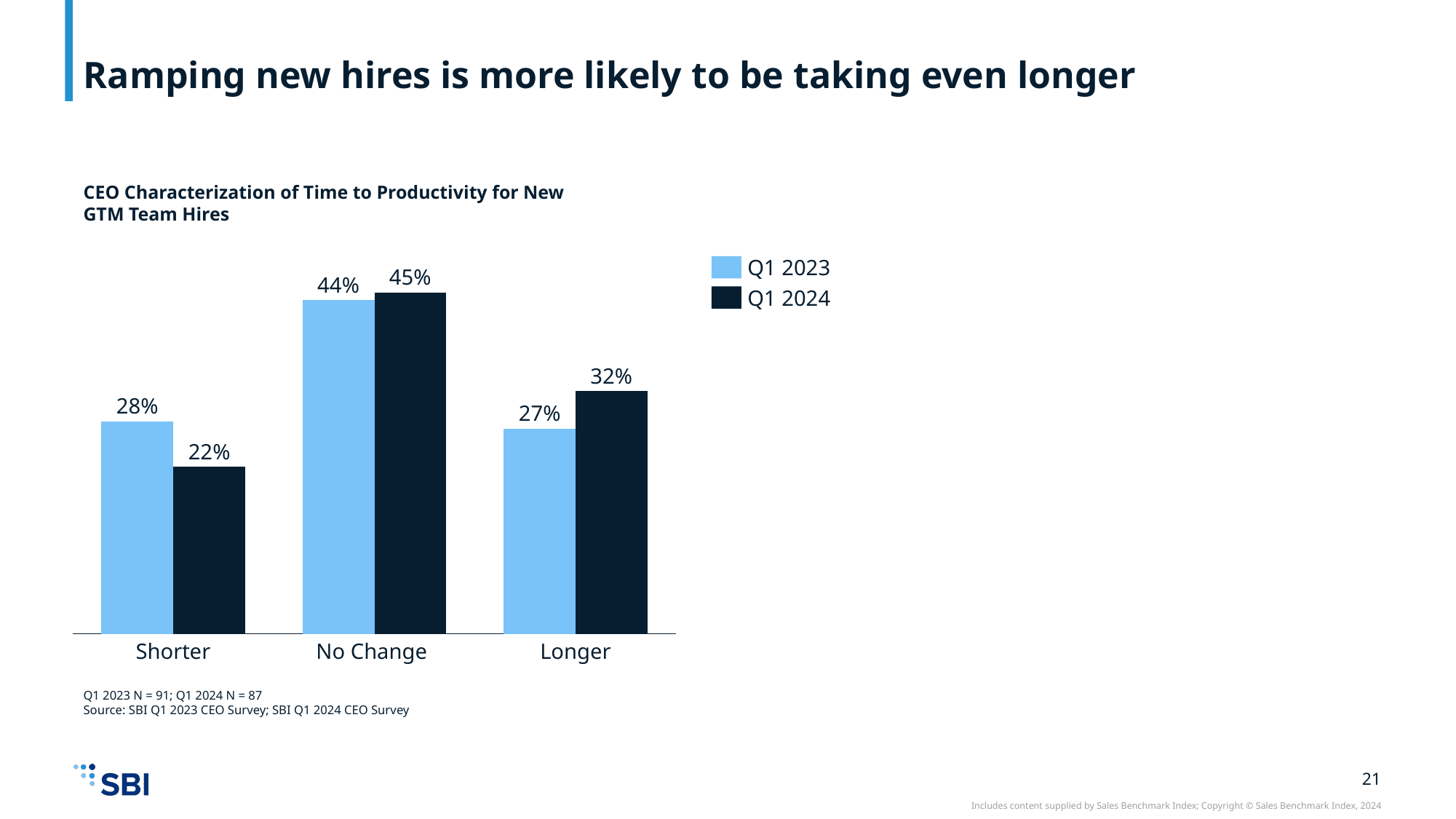
What is the difference between the Q1 2024 and Q1 2023 values for the Longer category? 5% What is the Q1 2024 value for the No Change category? 45% For the Shorter category, which is larger: the Q1 2023 value or the Q1 2024 value? Q1 2023 What is the difference between the Q1 2023 and Q1 2024 values for the Shorter category? 6% What is the title of the chart? CEO Characterization of Time to Productivity for New GTM Team Hires What is the Q1 2023 value for the Shorter category? 28% How many series does the legend list? 2 What is the Q1 2024 value for the Longer category? 32% Which category has the highest Q1 2023 value? No Change What kind of chart is shown on the slide? Bar chart Which category has the lowest Q1 2024 value? Shorter How many categories are shown on the x axis? 3